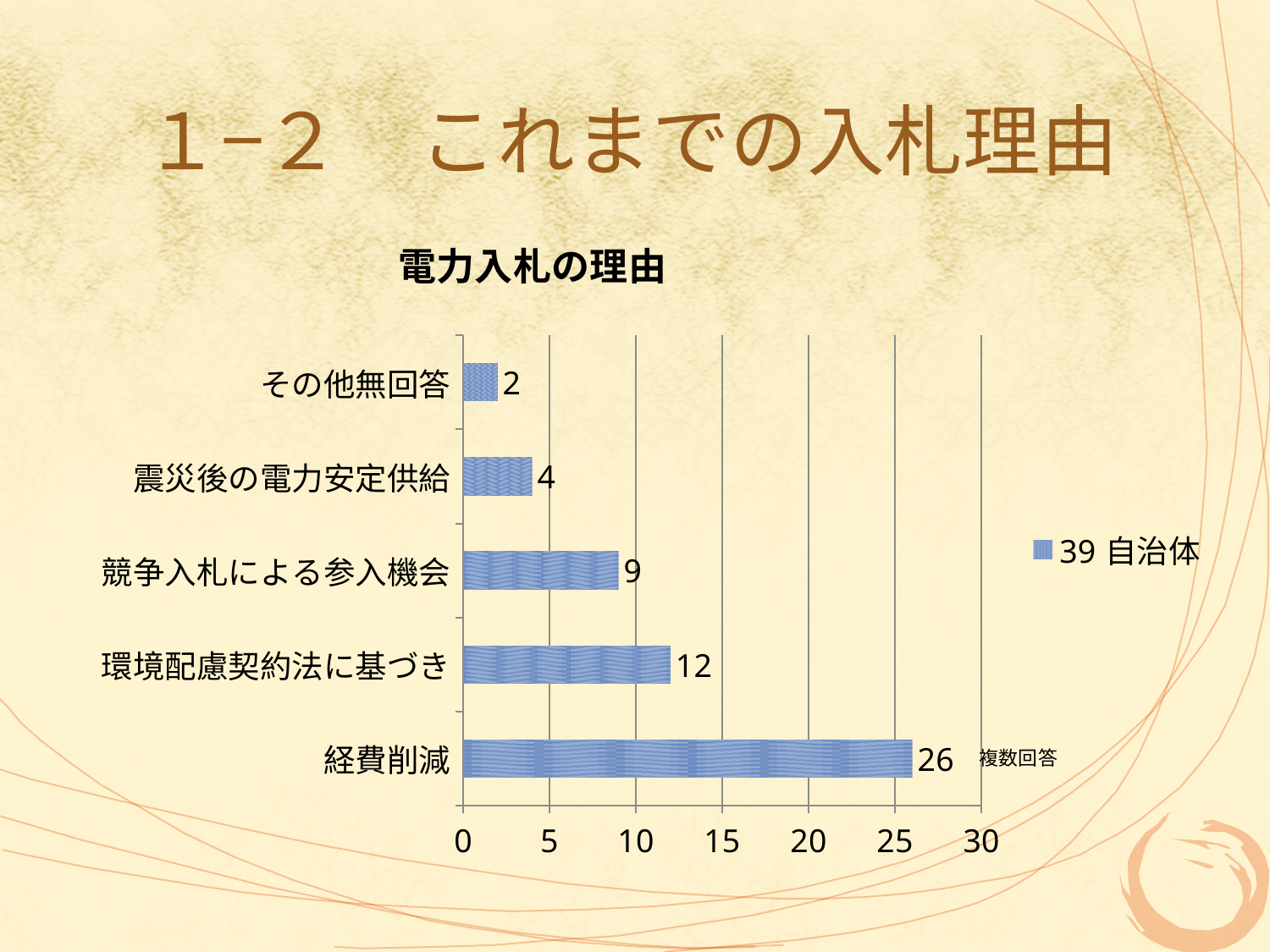
What is the value for 競争入札による参入機会? 9 How many series does the legend list? 1 What is the value for 環境配慮契約法に基づき? 12 Which category has the lowest value? その他無回答 How many categories are shown in the chart? 5 What kind of chart is shown? bar chart Which is larger, the value for 競争入札による参入機会 or the value for 震災後の電力安定供給? 競争入札による参入機会 What is the value for 経費削減? 26 What is the title of the chart? 電力入札の理由 What is the value for 震災後の電力安定供給? 4 What is the difference between the values for 経費削減 and 環境配慮契約法に基づき? 14 Which category has the highest value? 経費削減